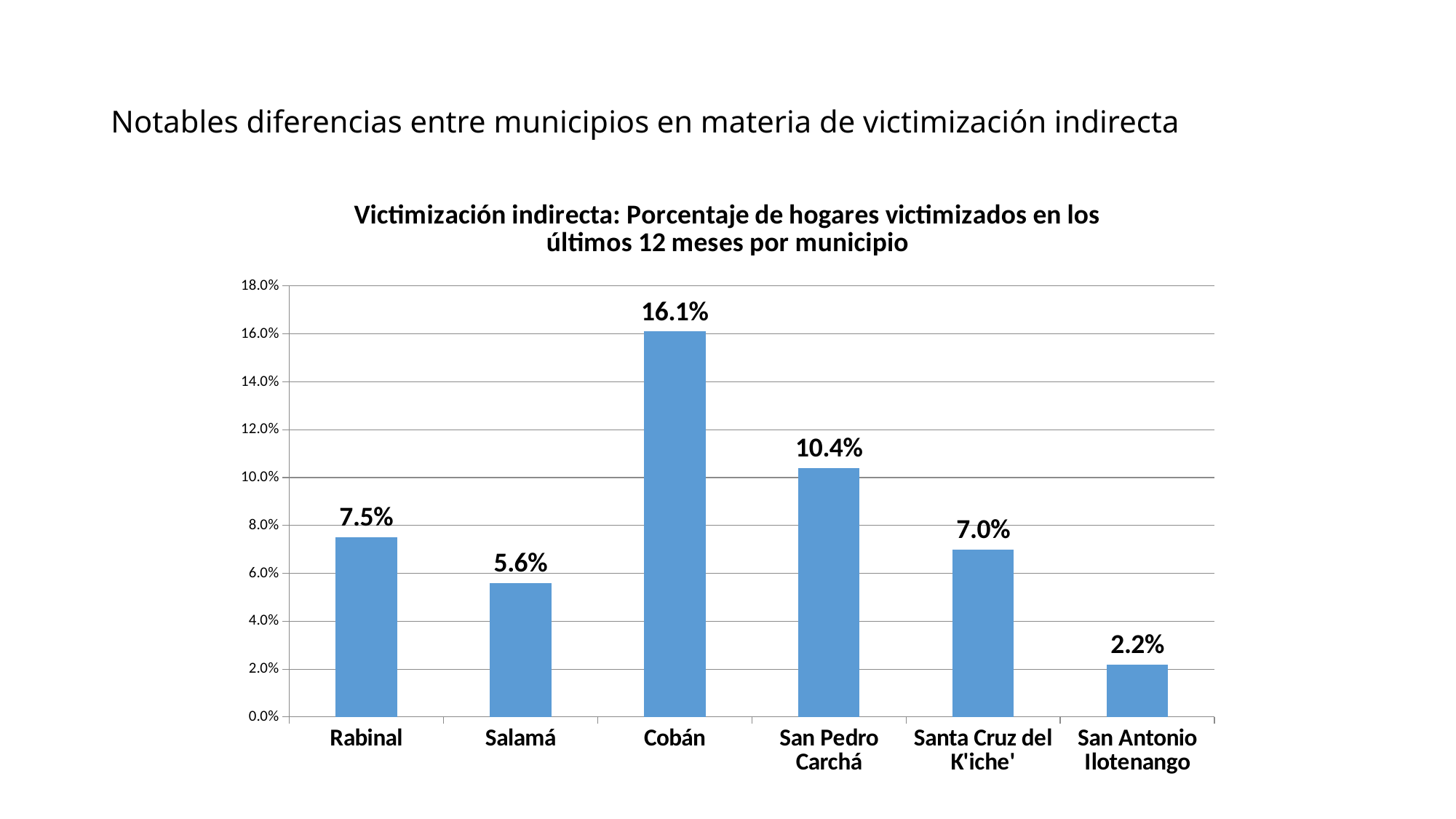
What is the value for San Antonio Ilotenango? 2.2% Which municipality has the lowest value? San Antonio Ilotenango What kind of chart is this? bar chart How many municipalities are shown on the chart? 6 Is the value for San Pedro Carchá greater or less than 10.0%? greater What is the difference between the values for Rabinal and Salamá? 1.9% Which municipality has the highest value? Cobán Which is larger, the value for Rabinal or the value for Santa Cruz del K'iche'? Rabinal What is the value for Cobán? 16.1% What is the value for Santa Cruz del K'iche'? 7.0% What is the title of the chart? Victimización indirecta: Porcentaje de hogares victimizados en los últimos 12 meses por municipio What is the difference between the values for Cobán and San Pedro Carchá? 5.7%